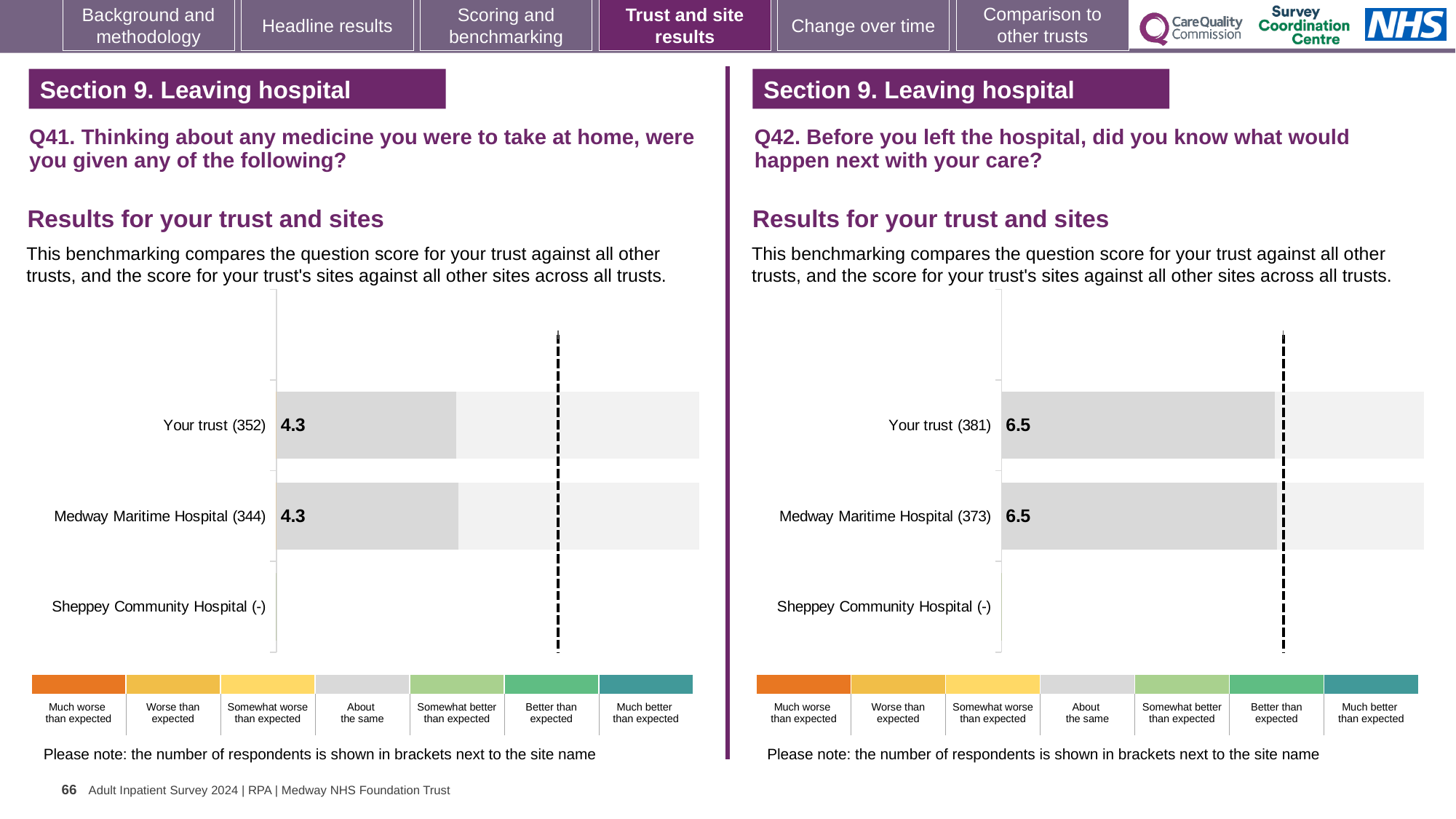
How many categories are listed on the Q42 chart (right)? 3 On the Q42 chart (right), how many respondents are shown in brackets for Medway Maritime Hospital? 373 Is the score for Your trust on the Q42 chart (right) larger than the score for Your trust on the Q41 chart (left)? Yes On the Q42 chart (right), what is the score for Your trust? 6.5 On the Q42 chart (right), what is the score for Medway Maritime Hospital? 6.5 On the Q41 chart (left), what is the difference between the score for Your trust and the score for Medway Maritime Hospital? 0 What kind of chart is the Q42 chart (right)? Bar chart On the Q41 chart (left), what is the score for Medway Maritime Hospital? 4.3 On the Q41 chart (left), what is the score for Your trust? 4.3 How many categories are listed on the Q41 chart (left)? 3 On the Q42 chart (right), what is the difference between the score for Your trust and the score for Medway Maritime Hospital? 0 On the Q41 chart (left), how many respondents are shown in brackets for Your trust? 352